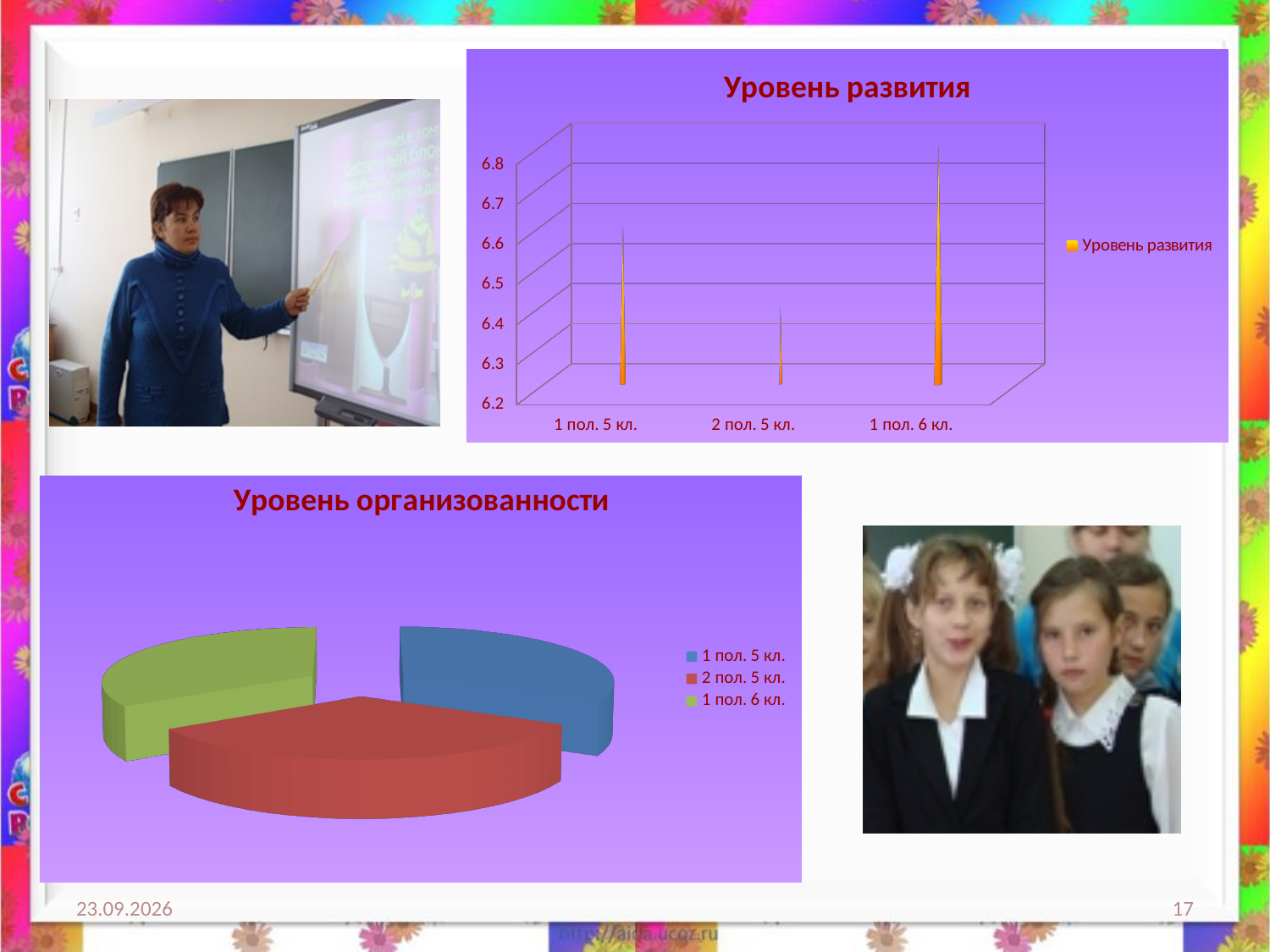
In the pie chart titled 'Уровень организованности', what colour is the slice for 1 пол. 6 кл.? Green In the chart titled 'Уровень развития', is the value for 2 пол. 5 кл. greater or less than 6.5? less How many slices does the pie chart titled 'Уровень организованности' have? 3 How many series does the legend of the chart titled 'Уровень развития' list? 1 In the chart titled 'Уровень развития', which is larger: the value for 1 пол. 5 кл. or the value for 2 пол. 5 кл.? 1 пол. 5 кл. What kind of chart is the chart titled 'Уровень организованности'? Pie chart In the chart titled 'Уровень развития', which category has the lowest value? 2 пол. 5 кл. In the chart titled 'Уровень развития', which category has the highest value? 1 пол. 6 кл. In the chart titled 'Уровень развития', is the value for 1 пол. 5 кл. greater or less than 6.5? greater In the chart titled 'Уровень развития', is the value for 1 пол. 6 кл. greater or less than 6.7? greater How many categories are shown on the x axis of the chart titled 'Уровень развития'? 3